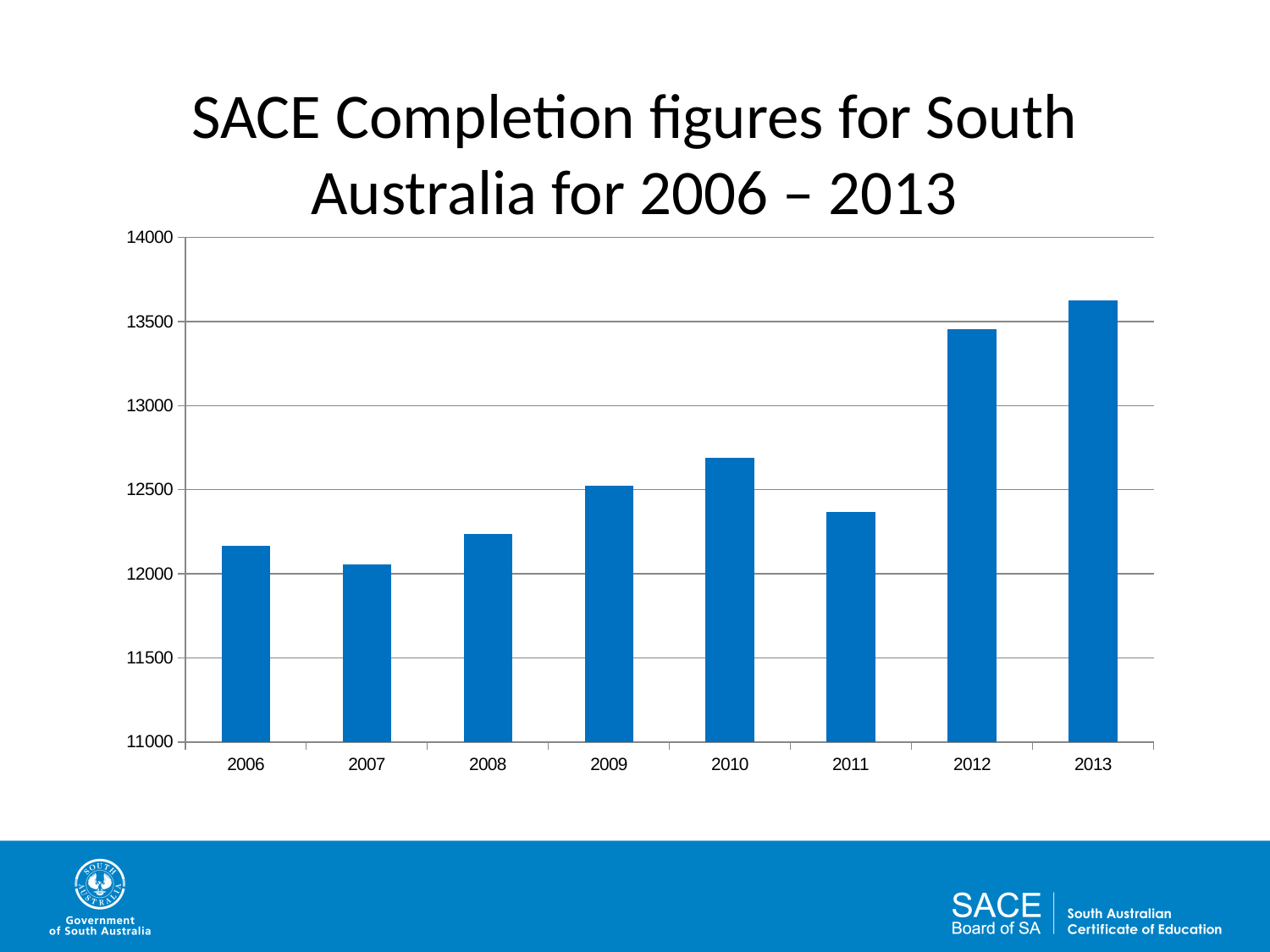
Do the SACE completion figures generally rise or fall from 2006 to 2013? rise What is the title of the chart on the slide? SACE Completion figures for South Australia for 2006 – 2013 Is the value for 2013 greater or less than 13500? greater Is the value for 2006 greater or less than 12000? greater How many years are shown on the x axis of the chart? 8 Which year has the lowest SACE completion figure? 2007 Is the value for 2012 greater or less than 13500? less Which year has the larger completion figure, 2011 or 2012? 2012 Which year has the highest SACE completion figure? 2013 What kind of chart is shown on the slide? bar chart